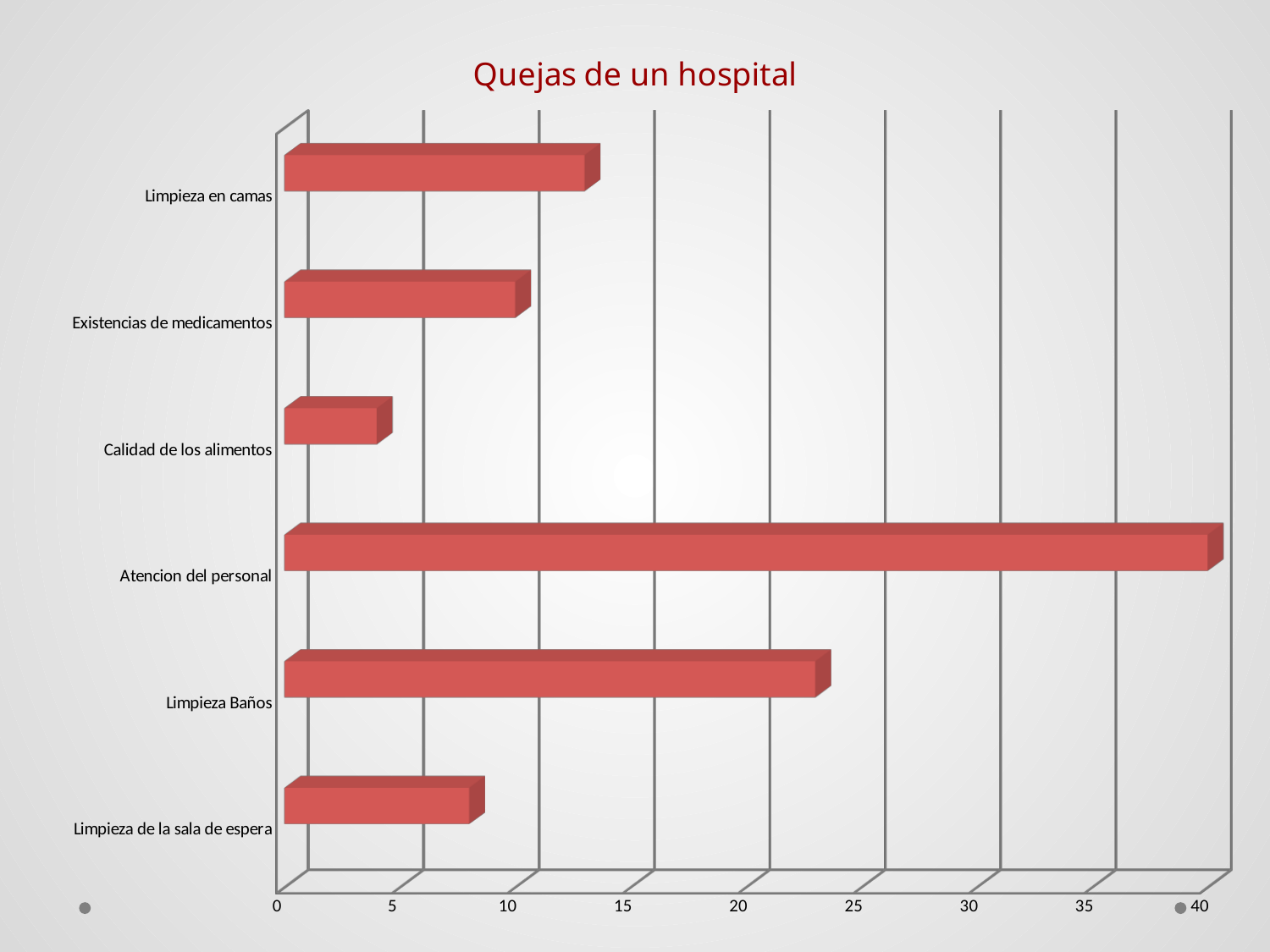
Is the value for Limpieza Baños greater or less than 20? greater Is the value for Limpieza en camas greater or less than 10? greater Is the value for Atencion del personal greater or less than 35? greater Which category has the lowest value? Calidad de los alimentos Which category has the highest value? Atencion del personal What type of chart is shown on the slide? bar chart What is the title of the chart? Quejas de un hospital Which is larger, the value for Limpieza Baños or the value for Limpieza en camas? Limpieza Baños How many categories are plotted in the chart? 6 Which is larger, the value for Existencias de medicamentos or the value for Limpieza de la sala de espera? Existencias de medicamentos